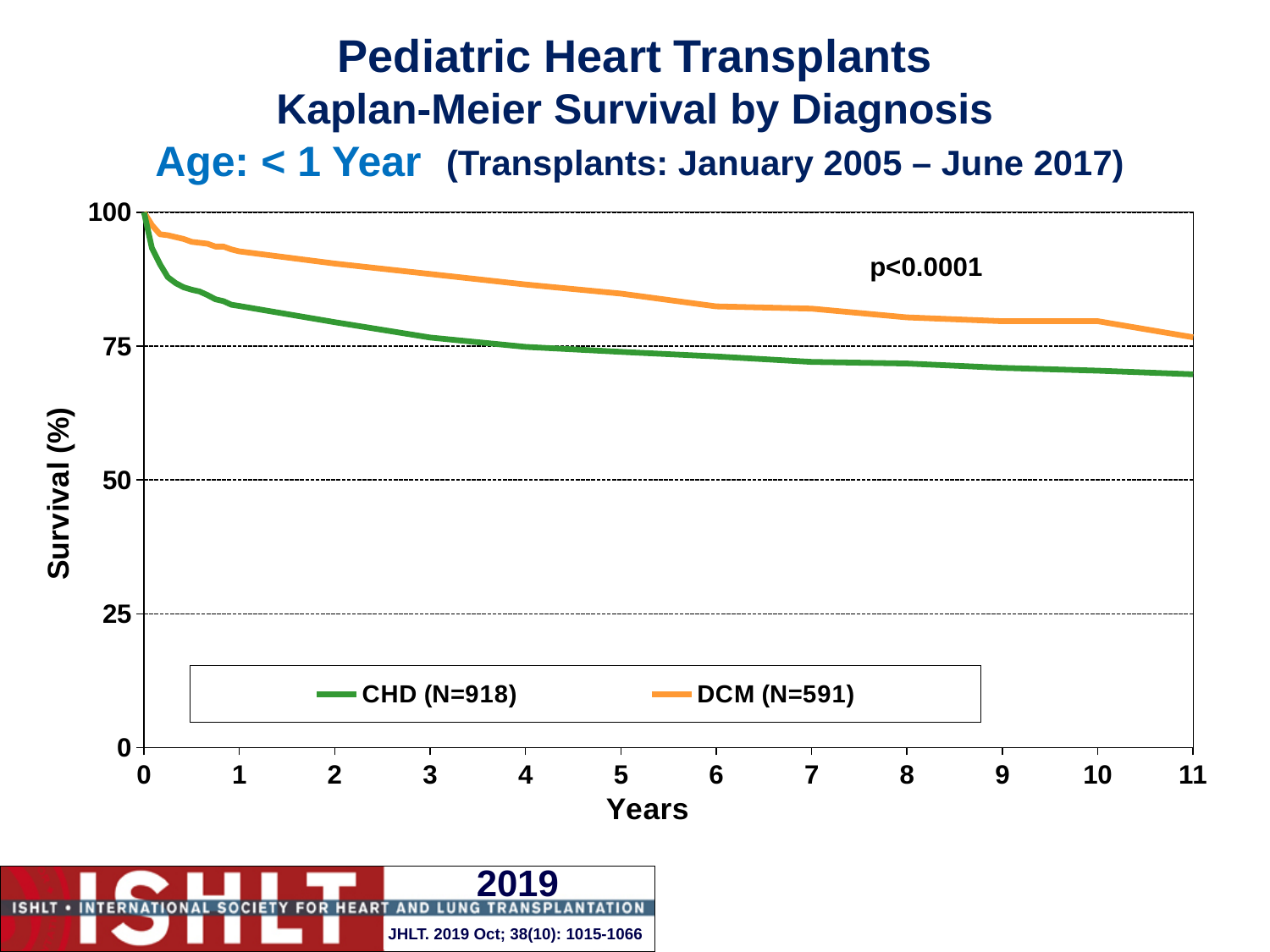
Is the survival value for CHD at year 8 greater or less than 75? less Which series has the higher survival at year 5, CHD or DCM? DCM Is the survival value for DCM at year 11 greater or less than 75? greater Is the survival value for DCM at year 1 greater or less than 75? greater Do the survival curves rise or fall as years increase? fall What is the survival value for both groups at year 0? 100 Which diagnosis group shows the lower survival across the follow-up period? CHD What is the number of patients (N) in the CHD group according to the legend? 918 How many series does the legend list? 2 What kind of chart is shown on the slide? line chart What p-value is printed on the chart? p<0.0001